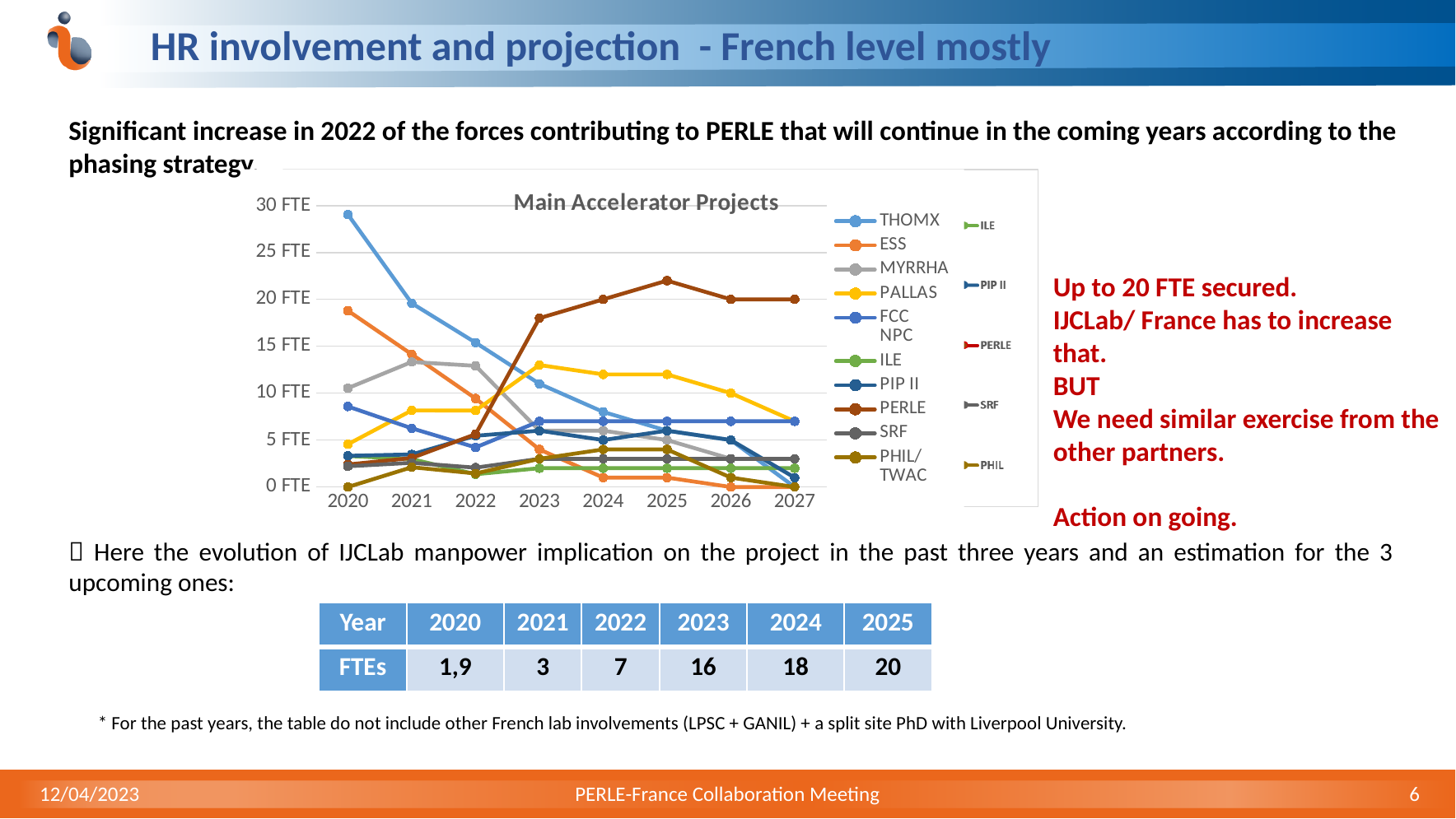
In the "Main Accelerator Projects" chart, which is larger in 2024: PERLE or PALLAS? PERLE In the "Main Accelerator Projects" chart, which project has the highest value in 2025? PERLE How many series does the legend of the "Main Accelerator Projects" chart list? 10 In the "Main Accelerator Projects" chart, is the value for PERLE in 2020 greater or less than 5 FTE? less In the "Main Accelerator Projects" chart, is the value for PALLAS in 2023 greater or less than 10 FTE? greater In the "Main Accelerator Projects" chart, does the THOMX series rise or fall from 2020 to 2027? fall In the "Main Accelerator Projects" chart, is the value for THOMX in 2020 greater or less than 25 FTE? greater How many years are shown on the x axis of the "Main Accelerator Projects" chart? 8 In the "Main Accelerator Projects" chart, which project has the highest value in 2020? THOMX What is the title of the line chart on the slide? Main Accelerator Projects What type of chart is the "Main Accelerator Projects" chart? line chart